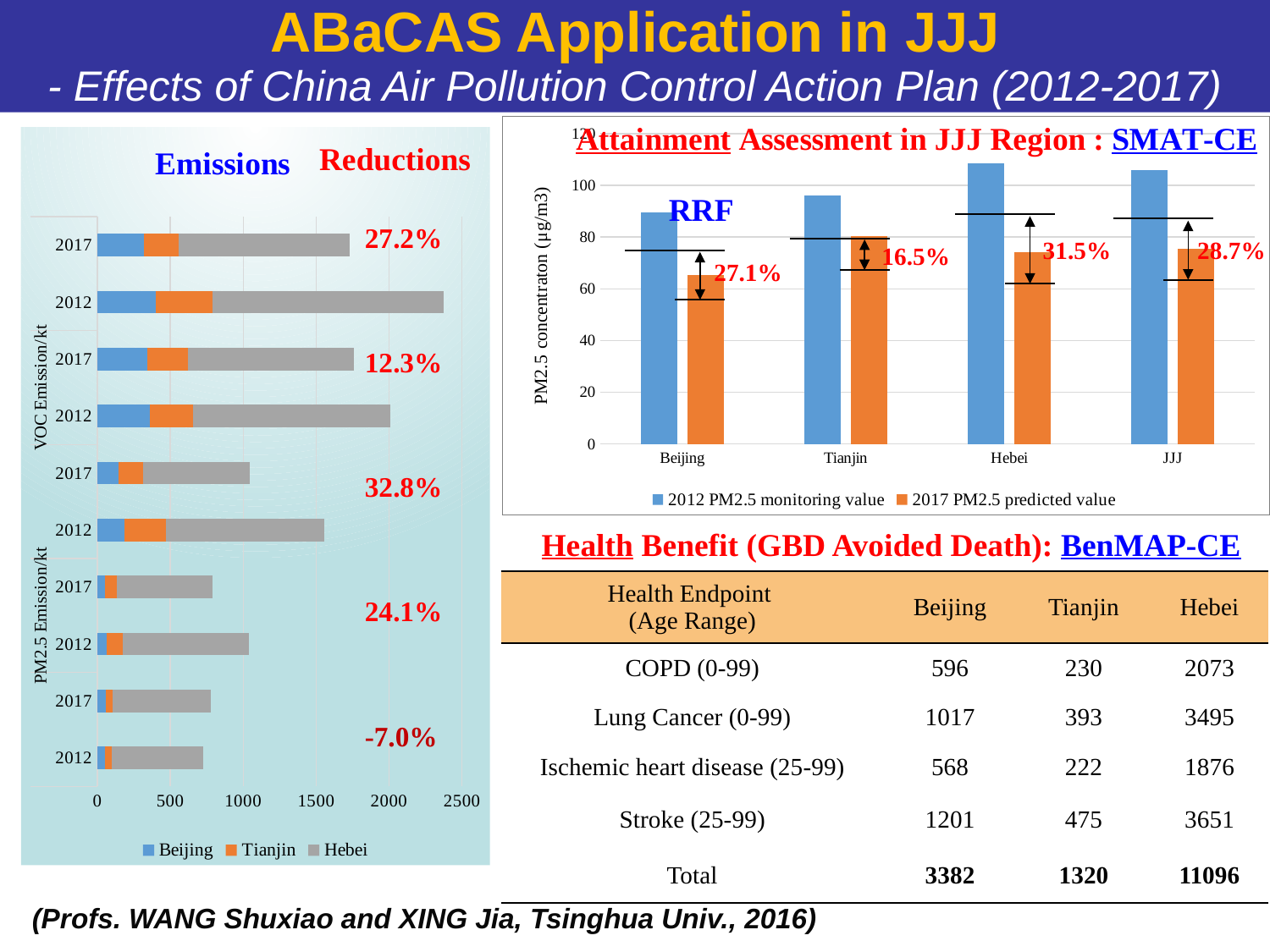
How many series does the legend of the Emissions chart on the left list? 3 How many series does the legend of the Attainment Assessment in JJJ Region chart list? 2 In the Attainment Assessment in JJJ Region chart, what reduction percentage is shown for Hebei? 31.5% In the Attainment Assessment in JJJ Region chart, which is larger for Tianjin: the 2012 PM2.5 monitoring value or the 2017 PM2.5 predicted value? 2012 PM2.5 monitoring value In the Attainment Assessment in JJJ Region chart, which region has the lowest 2012 PM2.5 monitoring value? Beijing What kind of chart is the Attainment Assessment in JJJ Region chart? bar chart How many regions are shown on the x axis of the Attainment Assessment in JJJ Region chart? 4 In the Attainment Assessment in JJJ Region chart, is the 2012 PM2.5 monitoring value for Hebei greater or less than 100? greater In the Emissions chart on the left, is the total length of the topmost 2012 bar greater or less than 2000? greater In the Emissions chart on the left, which reduction percentage shown is the lowest? -7.0% In the Emissions chart on the left, what reduction percentage is shown for PM2.5 Emission? 24.1% In the Attainment Assessment in JJJ Region chart, is the 2017 PM2.5 predicted value for Beijing greater or less than 80? less